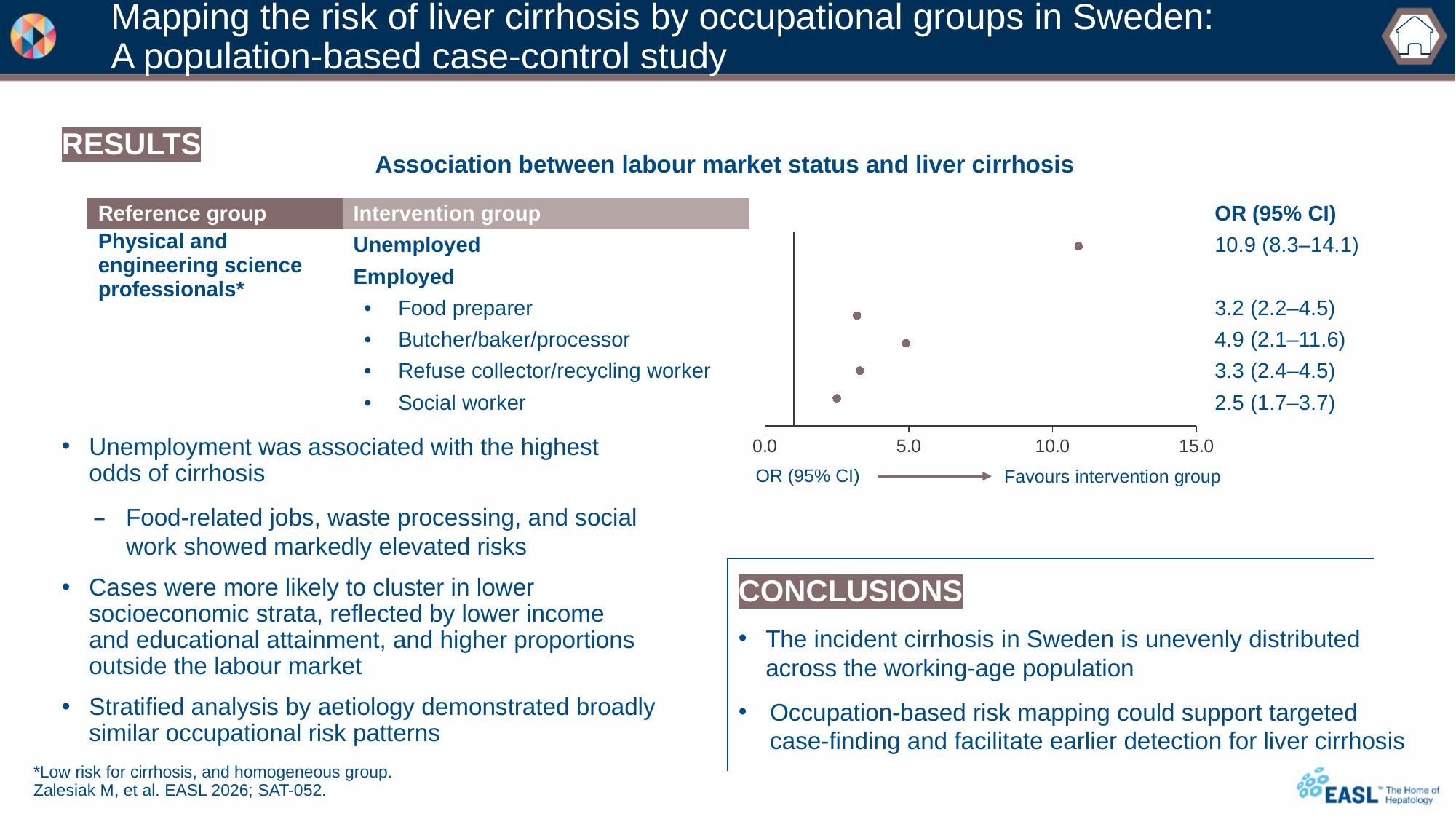
What is the OR (95% CI) shown for Butcher/baker/processor? 4.9 (2.1–11.6) Which has a larger odds ratio, Butcher/baker/processor or Refuse collector/recycling worker? Butcher/baker/processor What is the title of the chart? Association between labour market status and liver cirrhosis What kind of chart is used to show the odds ratios? Dot plot (forest plot) Which intervention group has the highest odds ratio? Unemployed What is the odds ratio (OR) for the Unemployed group? 10.9 Is the OR for Unemployed greater or less than 10.0? greater What is the OR (95% CI) shown for Social worker? 2.5 (1.7–3.7) What is the difference between the OR for Unemployed and the OR for Food preparer? 7.7 Which intervention group has the lowest odds ratio? Social worker How many intervention groups are plotted in the chart? 5 Is the OR for Social worker greater or less than 5.0? less